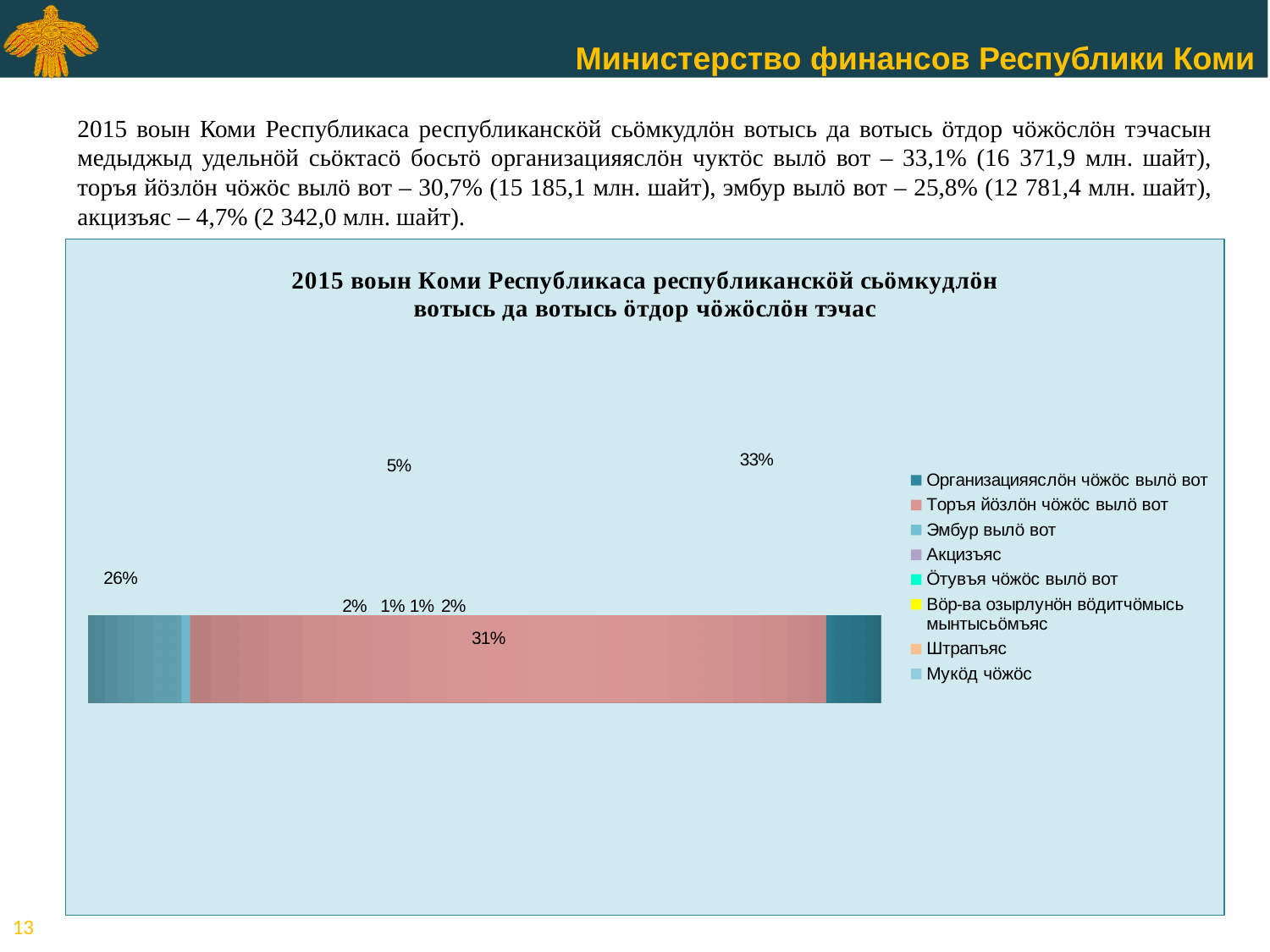
How many series does the chart legend list? 8 What is the largest percentage label shown on the chart? 33% What is the smallest percentage label shown on the chart? 1% What is the difference between the shares for Торъя йöзлöн чöжöс вылö вот (31%) and Эмбур вылö вот (26%)? 5% Which series has the largest share in the chart? Организацияяслöн чöжöс вылö вот What share is shown for Торъя йöзлöн чöжöс вылö вот? 31% What is the difference between the shares for Организацияяслöн чöжöс вылö вот (33%) and Торъя йöзлöн чöжöс вылö вот (31%)? 2% Which legend entry is listed first in the chart legend? Организацияяслöн чöжöс вылö вот What share is shown for Акцизъяс? 5% Which is larger: the share for Организацияяслöн чöжöс вылö вот or for Торъя йöзлöн чöжöс вылö вот? Организацияяслöн чöжöс вылö вот What share is shown for Эмбур вылö вот? 26%